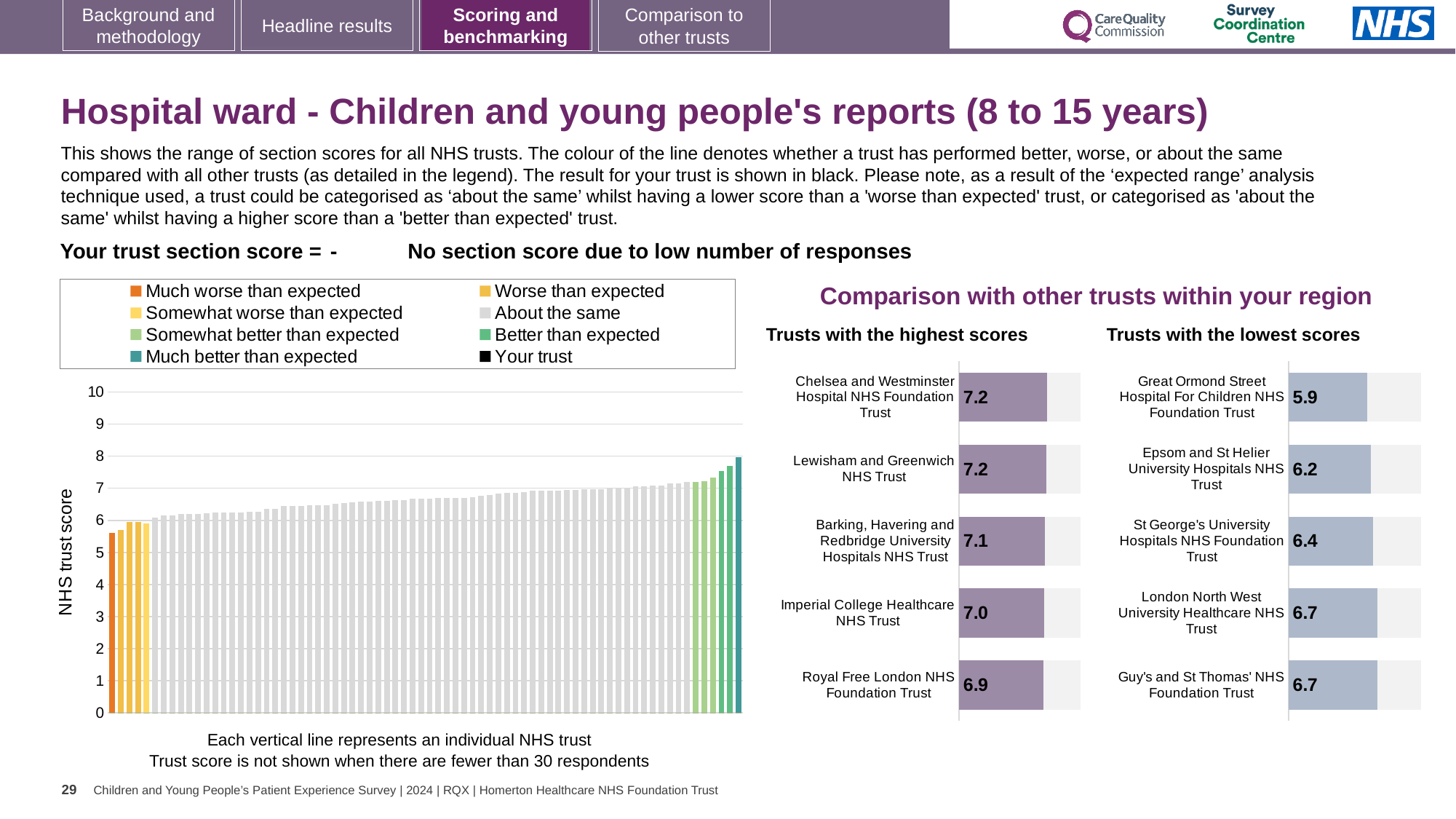
In the 'Trusts with the lowest scores' chart, what is the difference between the scores of Guy's and St Thomas' NHS Foundation Trust and Great Ormond Street Hospital For Children NHS Foundation Trust? 0.8 In the 'Trusts with the highest scores' chart, what is the score for Imperial College Healthcare NHS Trust? 7.0 In the 'Trusts with the highest scores' chart, which trust has the lowest score shown? Royal Free London NHS Foundation Trust What kind of chart is the NHS trust score chart on the left? bar chart In the 'Trusts with the lowest scores' chart, what is the score for Epsom and St Helier University Hospitals NHS Trust? 6.2 In the NHS trust score chart on the left, do the bar values rise or fall from left to right? rise How many trusts are listed in the 'Trusts with the lowest scores' chart? 5 How many entries does the legend above the NHS trust score chart list? 8 In the 'Trusts with the highest scores' chart, what is the difference between the scores of Chelsea and Westminster Hospital NHS Foundation Trust and Royal Free London NHS Foundation Trust? 0.3 In the 'Trusts with the highest scores' chart, which has the higher score: Barking, Havering and Redbridge University Hospitals NHS Trust or Royal Free London NHS Foundation Trust? Barking, Havering and Redbridge University Hospitals NHS Trust In the 'Trusts with the lowest scores' chart, which trust has the lowest score? Great Ormond Street Hospital For Children NHS Foundation Trust In the NHS trust score chart on the left, is the value of the tallest (rightmost) bar greater or less than 7? greater